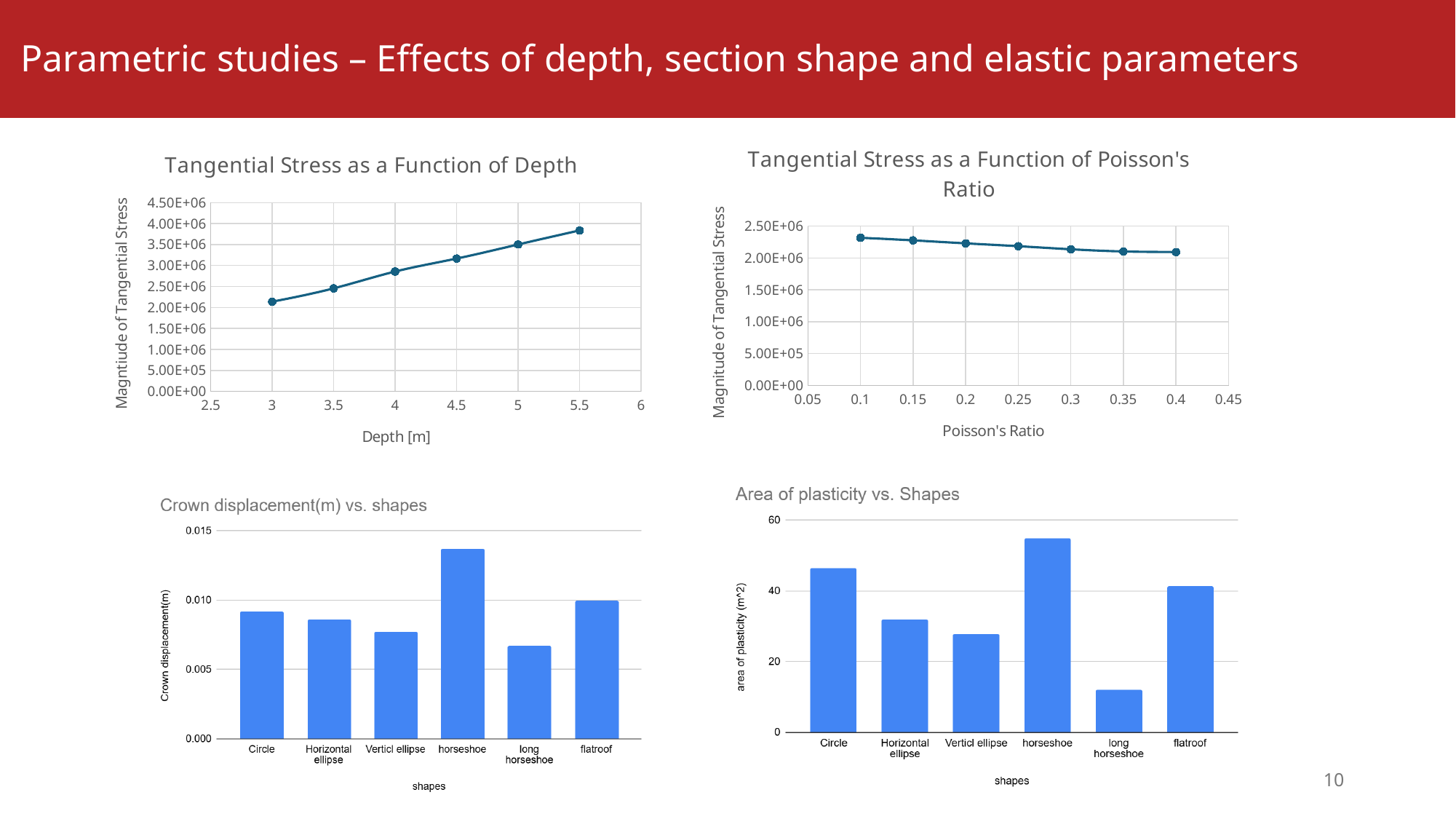
In the 'Crown displacement(m) vs. shapes' chart, which shape has the lowest crown displacement? long horseshoe In the 'Tangential Stress as a Function of Poisson's Ratio' chart, is the value at Poisson's ratio 0.1 greater or less than 2.00E+06? greater In the 'Crown displacement(m) vs. shapes' chart, which shape has the highest crown displacement? horseshoe In the 'Area of plasticity vs. Shapes' chart, which shape has the lowest area of plasticity? long horseshoe In the 'Tangential Stress as a Function of Depth' chart, does the tangential stress rise or fall as depth increases? rise In the 'Tangential Stress as a Function of Depth' chart, what kind of chart is shown? line chart In the 'Area of plasticity vs. Shapes' chart, which has a larger area of plasticity, Circle or flatroof? Circle In the 'Tangential Stress as a Function of Depth' chart, is the value at depth 5.5 greater or less than 4.00E+06? less In the 'Crown displacement(m) vs. shapes' chart, is the value for horseshoe greater or less than 0.010? greater In the 'Tangential Stress as a Function of Poisson's Ratio' chart, how many data points are plotted? 7 In the 'Tangential Stress as a Function of Depth' chart, how many data points are plotted? 6 In the 'Tangential Stress as a Function of Poisson's Ratio' chart, does the tangential stress rise or fall as Poisson's ratio increases? fall